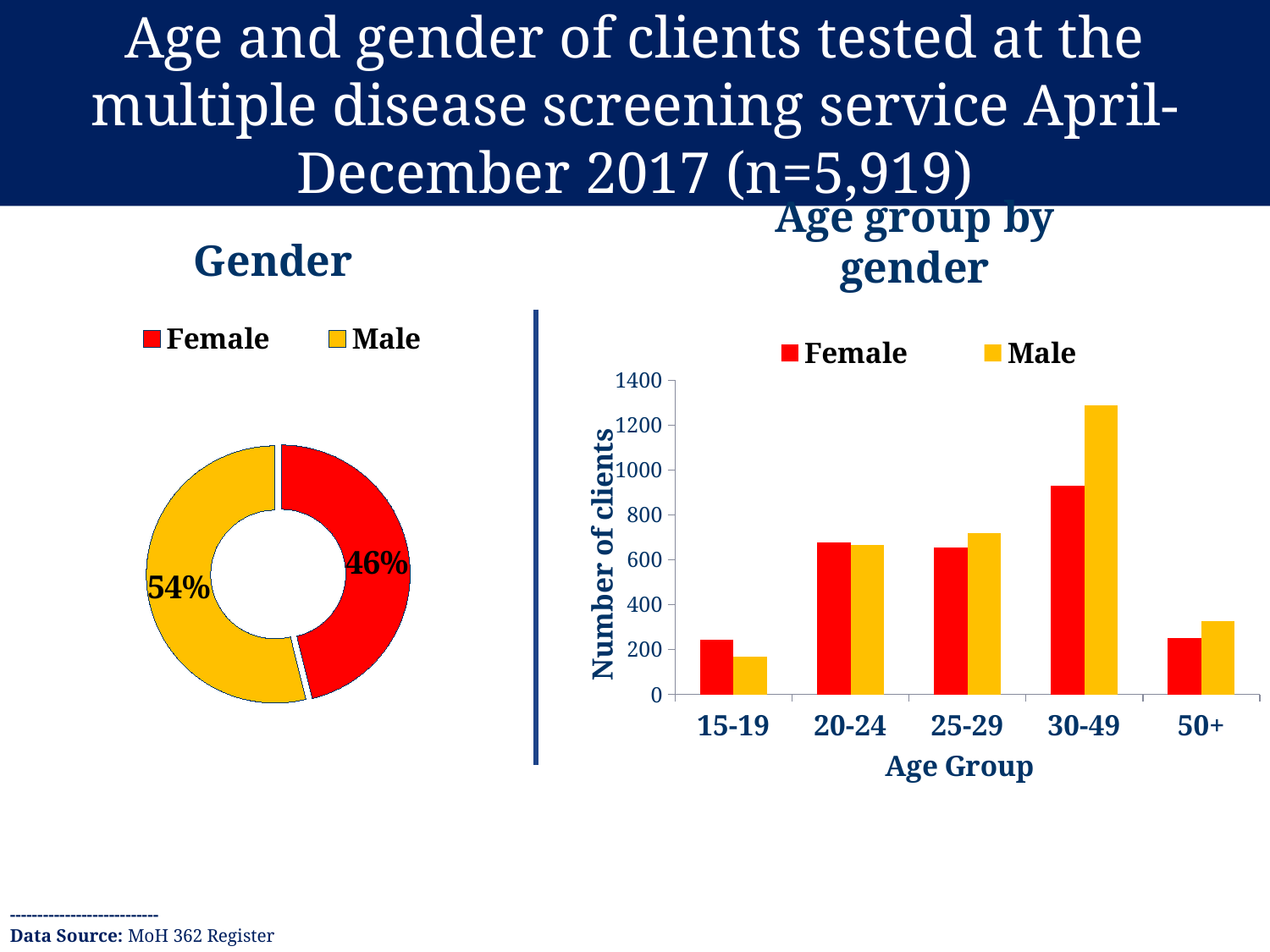
In the Gender chart, what percentage of clients were female? 46% What kind of chart is the Gender chart? Doughnut (pie) chart In the Age group by gender chart, is the number of female clients aged 15-19 greater or less than 400? less In the Age group by gender chart, which age group has the highest number of male clients? 30-49 In the Age group by gender chart, how many series does the legend list? 2 In the Gender chart, how many percentage points larger is the Male share than the Female share? 8 percentage points In the Age group by gender chart, which age group has the lowest number of male clients? 15-19 In the Age group by gender chart, how many age groups are shown on the x axis? 5 In the Age group by gender chart, is the number of male clients aged 30-49 greater or less than 1200? greater In the Gender chart, which gender has the larger share of clients? Male In the Gender chart, what percentage of clients were male? 54% In the Age group by gender chart, for the 30-49 age group, which is larger: the Female bar or the Male bar? Male